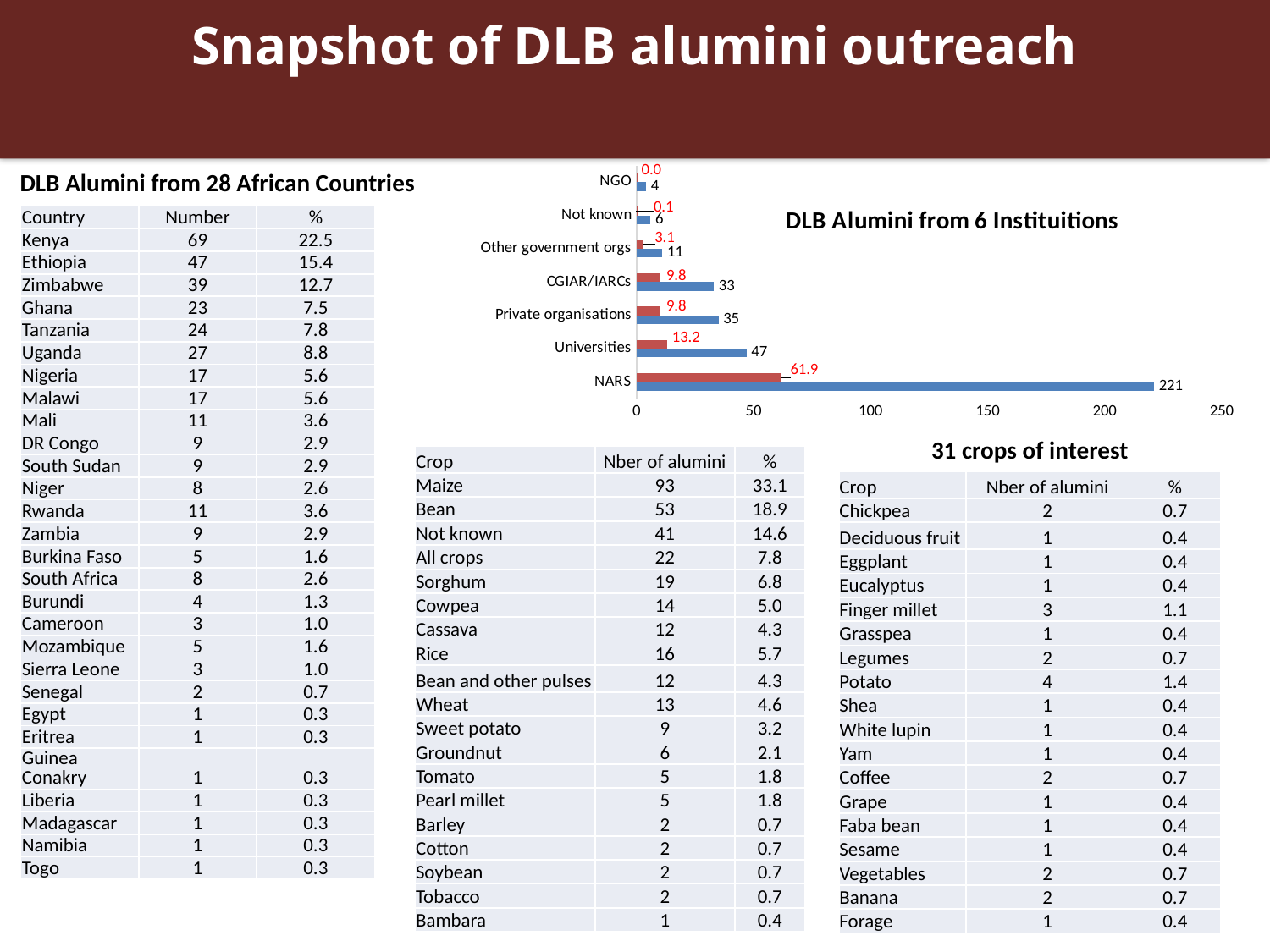
In the 'DLB Alumini from 6 Instituitions' chart, what is the number of alumni for Universities? 47 In the 'DLB Alumini from 6 Instituitions' chart, what is the number of alumni for NARS? 221 In the 'DLB Alumini from 6 Instituitions' chart, what is the number of alumni for NGO? 4 In the 'DLB Alumini from 6 Instituitions' chart, which institution has the lowest number of alumni? NGO How many institution categories are shown in the 'DLB Alumini from 6 Instituitions' chart? 7 In the 'DLB Alumini from 6 Instituitions' chart, what is the number of alumni for CGIAR/IARCs? 33 What kind of chart is 'DLB Alumini from 6 Instituitions'? bar chart In the 'DLB Alumini from 6 Instituitions' chart, what is the number of alumni for Private organisations? 35 In the 'DLB Alumini from 6 Instituitions' chart, what percentage value is shown for NARS? 61.9 In the 'DLB Alumini from 6 Instituitions' chart, which institution has the highest number of alumni? NARS In the 'DLB Alumini from 6 Instituitions' chart, what is the difference in number of alumni between NARS and Universities? 174 In the 'DLB Alumini from 6 Instituitions' chart, which has more alumni, Universities or Other government orgs? Universities